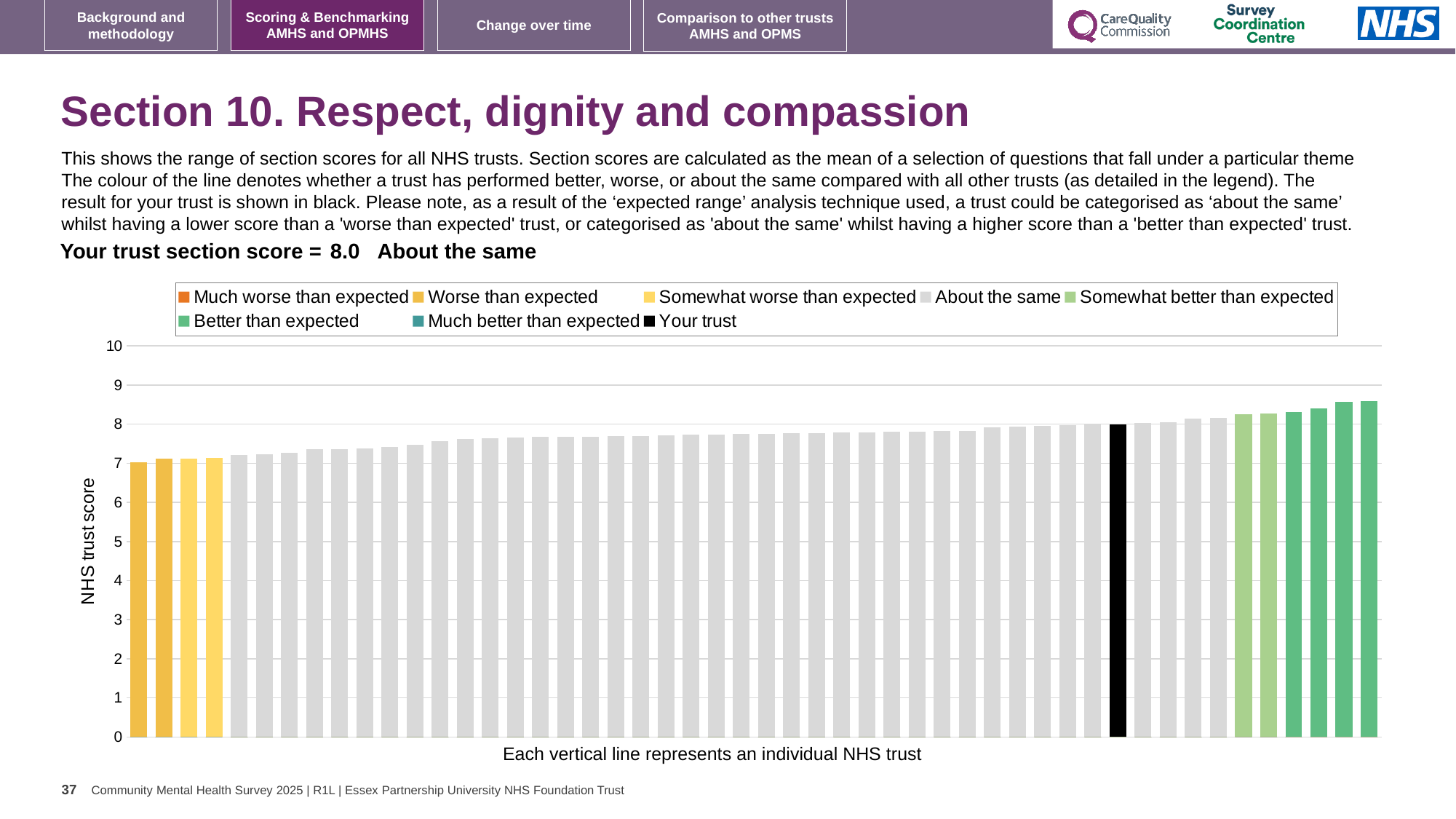
Which category is your trust placed in for this section? About the same What kind of chart is shown on the slide? bar chart What is the section score for your trust shown on the slide? 8.0 Is the value of the leftmost (lowest) bar greater or less than 8? less How many bars on the chart are coloured black? 1 What is the highest value shown on the vertical axis? 10 What is the label on the vertical axis of the chart? NHS trust score How many entries does the chart legend list? 8 Is the value for your trust's bar greater or less than 7? greater Do the bar values rise or fall from left to right across the chart? rise What colour is the bar representing your trust? black Is the value of the rightmost (highest) bar greater or less than 8? greater